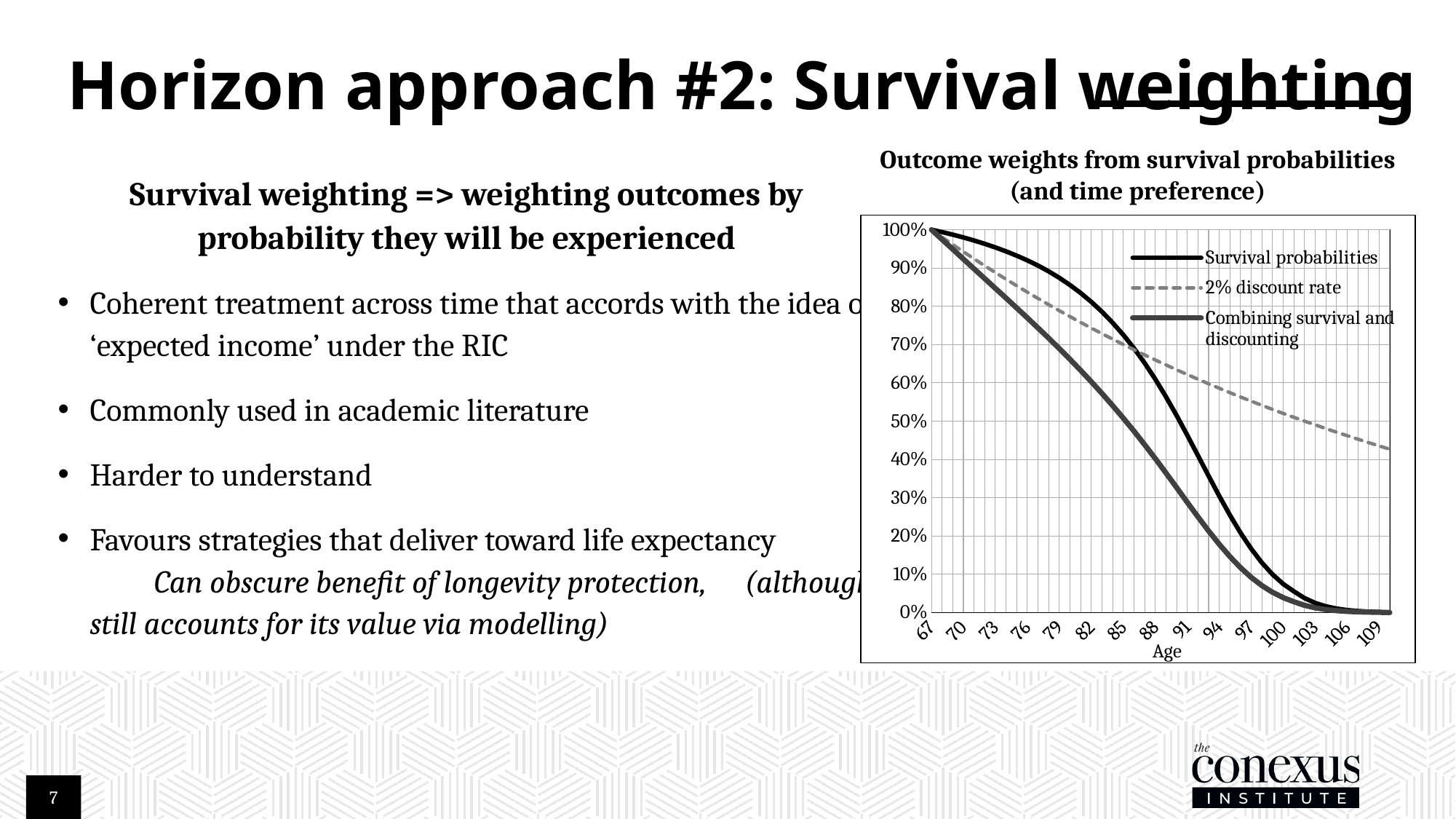
How many series does the chart legend list? 3 What is the title of the chart? Outcome weights from survival probabilities (and time preference) What is the value of the Survival probabilities series at age 67? 100% Is the value of the Survival probabilities series at age 79 greater or less than 80%? greater What is the label of the x axis of the chart? Age Do the values of the Survival probabilities series rise or fall as age increases? fall How many age tick labels are shown on the x axis? 15 What kind of chart is shown on the slide? line chart At age 100, which is larger: the Survival probabilities value or the 2% discount rate value? 2% discount rate Which series has the highest value at age 109? 2% discount rate Is the value of the Combining survival and discounting series at age 100 greater or less than 20%? less Which series has the lowest value at age 85? Combining survival and discounting